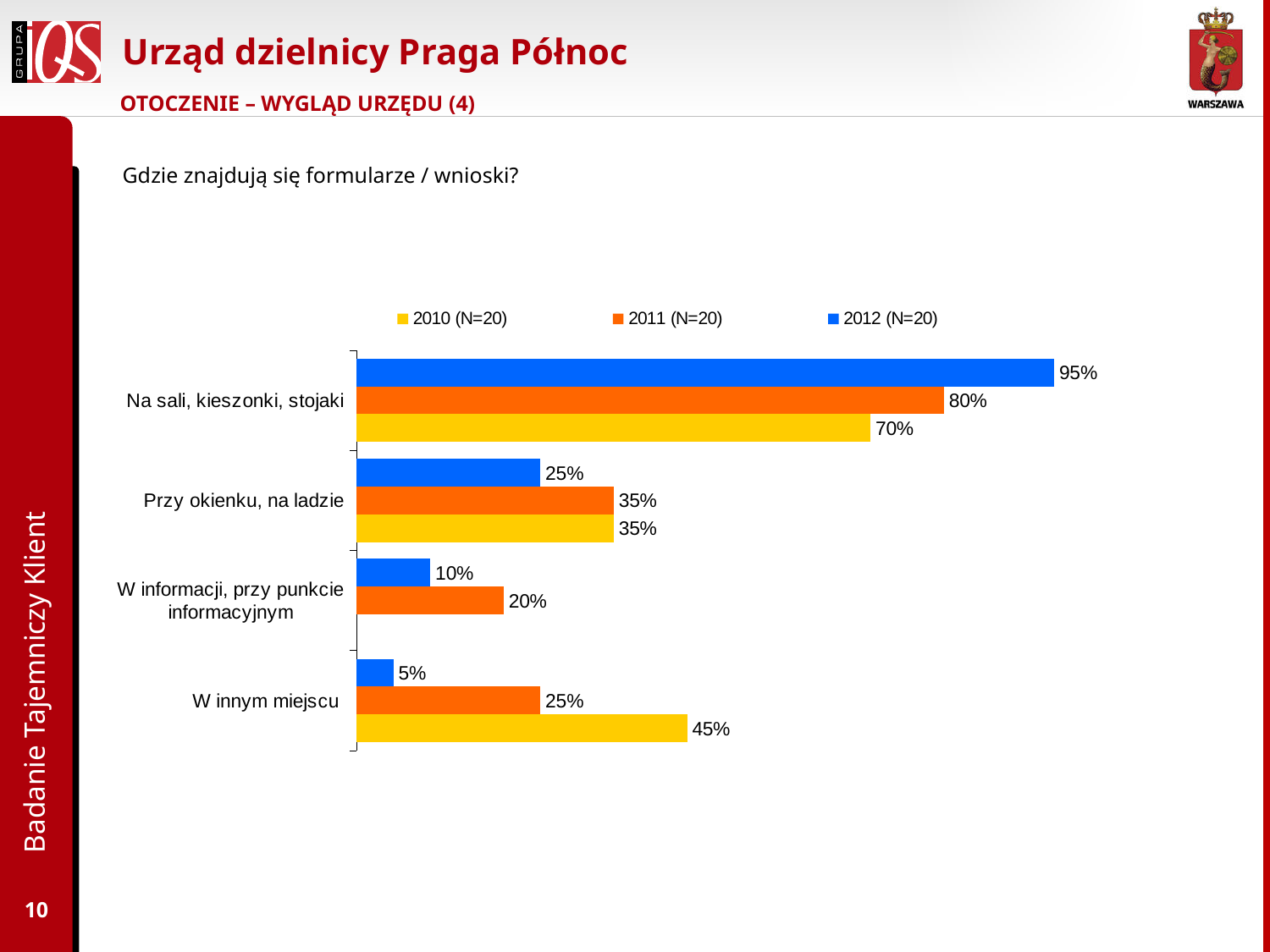
For "W innym miejscu", which series has the larger value: 2010 (N=20) or 2011 (N=20)? 2010 (N=20) Which category has the lowest value in the 2012 (N=20) series? W innym miejscu What is the difference between the 2012 (N=20) and 2010 (N=20) values for "Na sali, kieszonki, stojaki"? 25% How many categories are shown on the chart? 4 What is the value for "W innym miejscu" in the 2010 (N=20) series? 45% Which colour represents the 2011 (N=20) series? Orange Which category has the highest value in the 2012 (N=20) series? Na sali, kieszonki, stojaki What is the value for "Na sali, kieszonki, stojaki" in the 2012 (N=20) series? 95% What kind of chart is shown on the slide? Bar chart What is the value for "Przy okienku, na ladzie" in the 2012 (N=20) series? 25% What is the value for "W informacji, przy punkcie informacyjnym" in the 2011 (N=20) series? 20% How many series does the legend list? 3